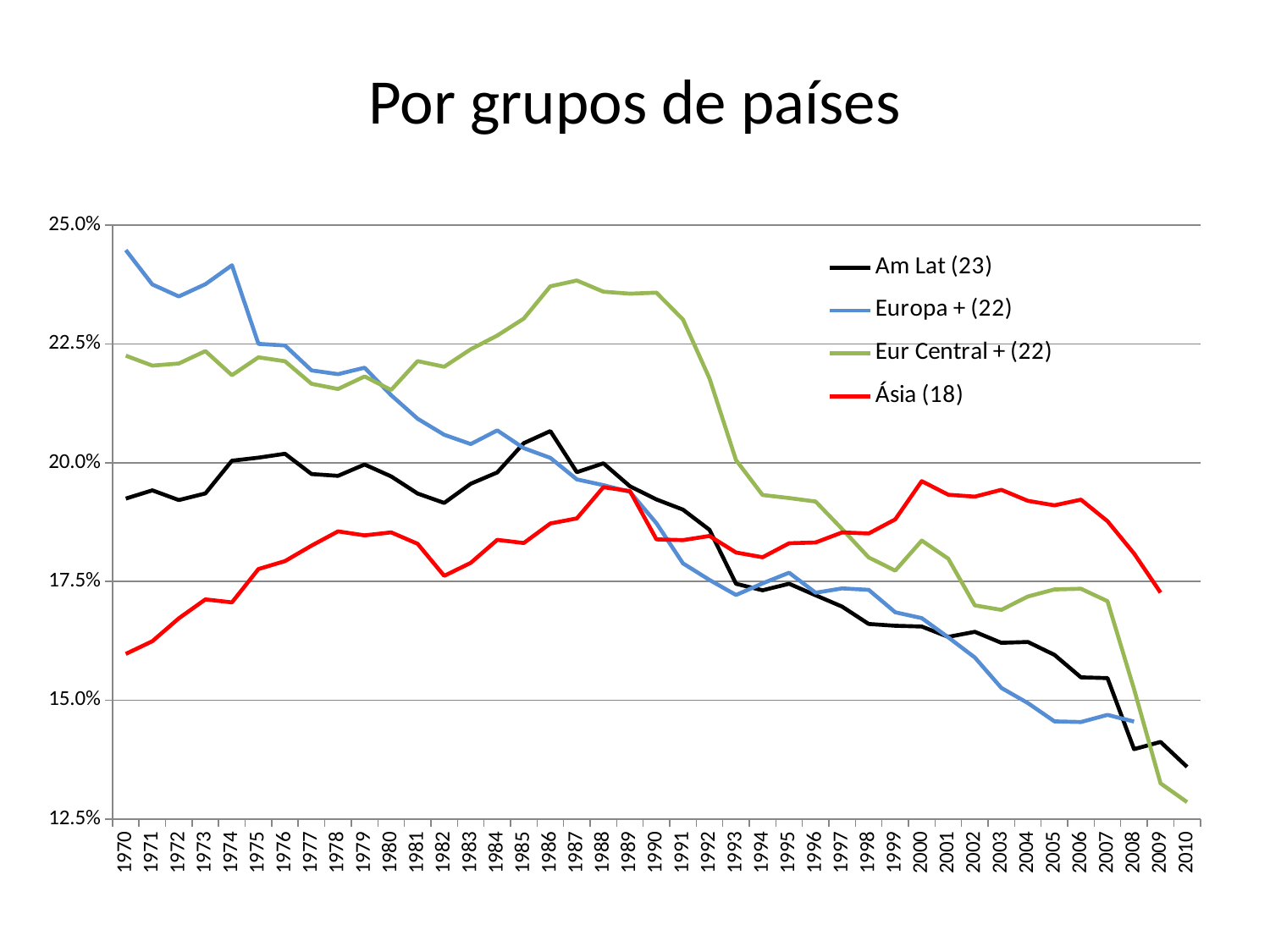
Which series has the lowest value in 1970? Ásia (18) Which series are listed in the legend? Am Lat (23), Europa + (22), Eur Central + (22), Ásia (18) Which series has the highest value in 2008? Ásia (18) What colour is the Ásia (18) line? red How many series does the legend list? 4 How many years are shown along the x axis? 41 Is the value for Eur Central + (22) in 2010 greater or less than 15.0%? less What kind of chart is shown on the slide? line chart Is the value for Europa + (22) in 1970 greater or less than 22.5%? greater Does the Europa + (22) line rise or fall from 1970 to 2008? fall Is the value for Ásia (18) in 1970 greater or less than 17.5%? less Which series has the highest value in 1970? Europa + (22)